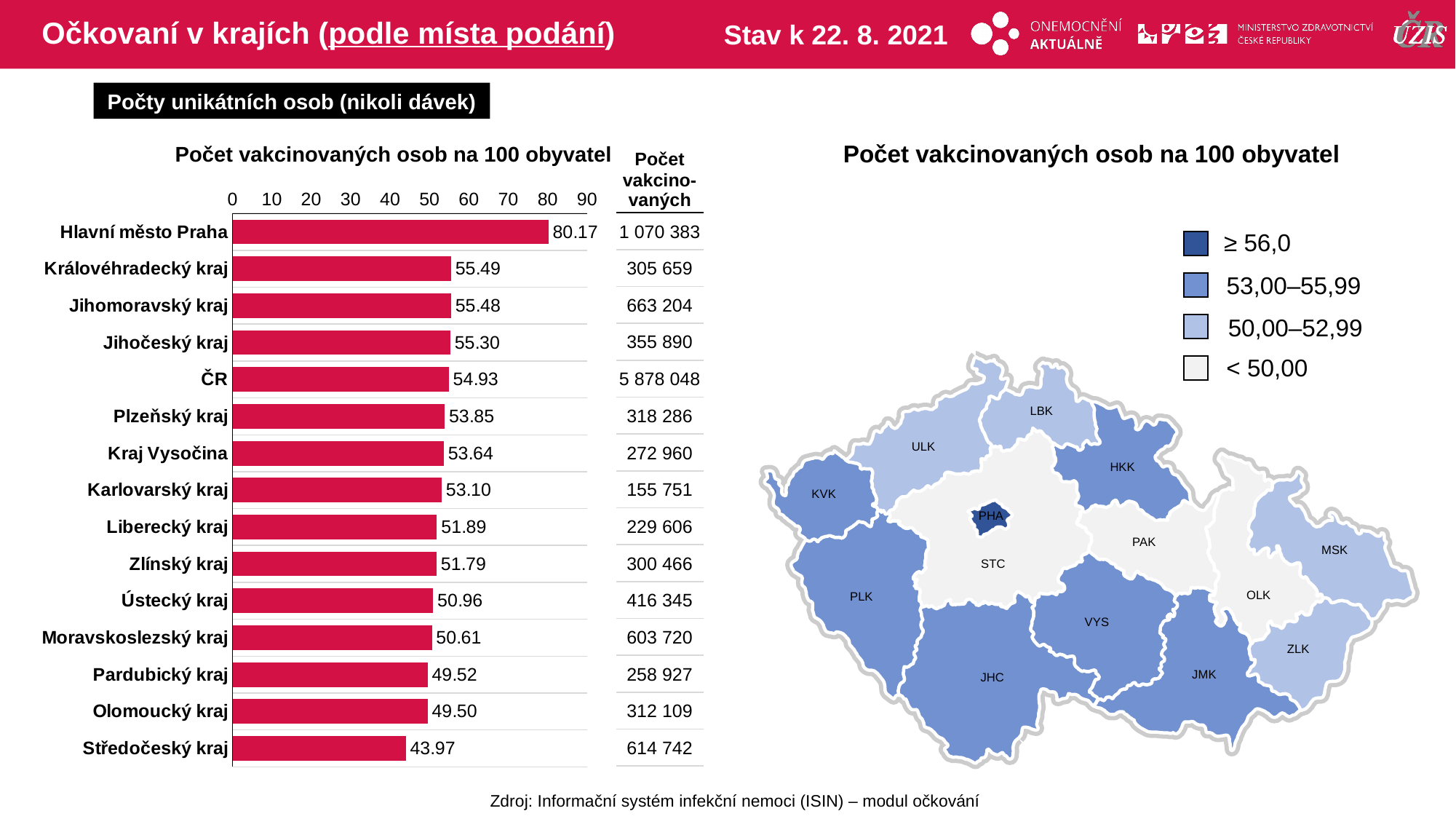
What kind of chart is shown on the left of the slide? bar chart How many bars (categories) does the bar chart show? 15 In the bar chart, what is the value for Hlavní město Praha? 80.17 In the bar chart, which region has the lowest number of vaccinated persons per 100 inhabitants? Středočeský kraj In the bar chart, what is the difference between the values for Hlavní město Praha and Středočeský kraj? 36.20 In the bar chart, what is the difference between the values for Královéhradecký kraj and Jihomoravský kraj? 0.01 In the bar chart, which region has the highest number of vaccinated persons per 100 inhabitants? Hlavní město Praha In the bar chart, what is the value for ČR? 54.93 What is the title of the bar chart on the left? Počet vakcinovaných osob na 100 obyvatel In the table next to the bar chart, what is the 'Počet vakcinovaných' value for Jihomoravský kraj? 663 204 In the bar chart, is the value for Středočeský kraj greater or less than 50? less In the bar chart, which has a higher value: Plzeňský kraj or Kraj Vysočina? Plzeňský kraj